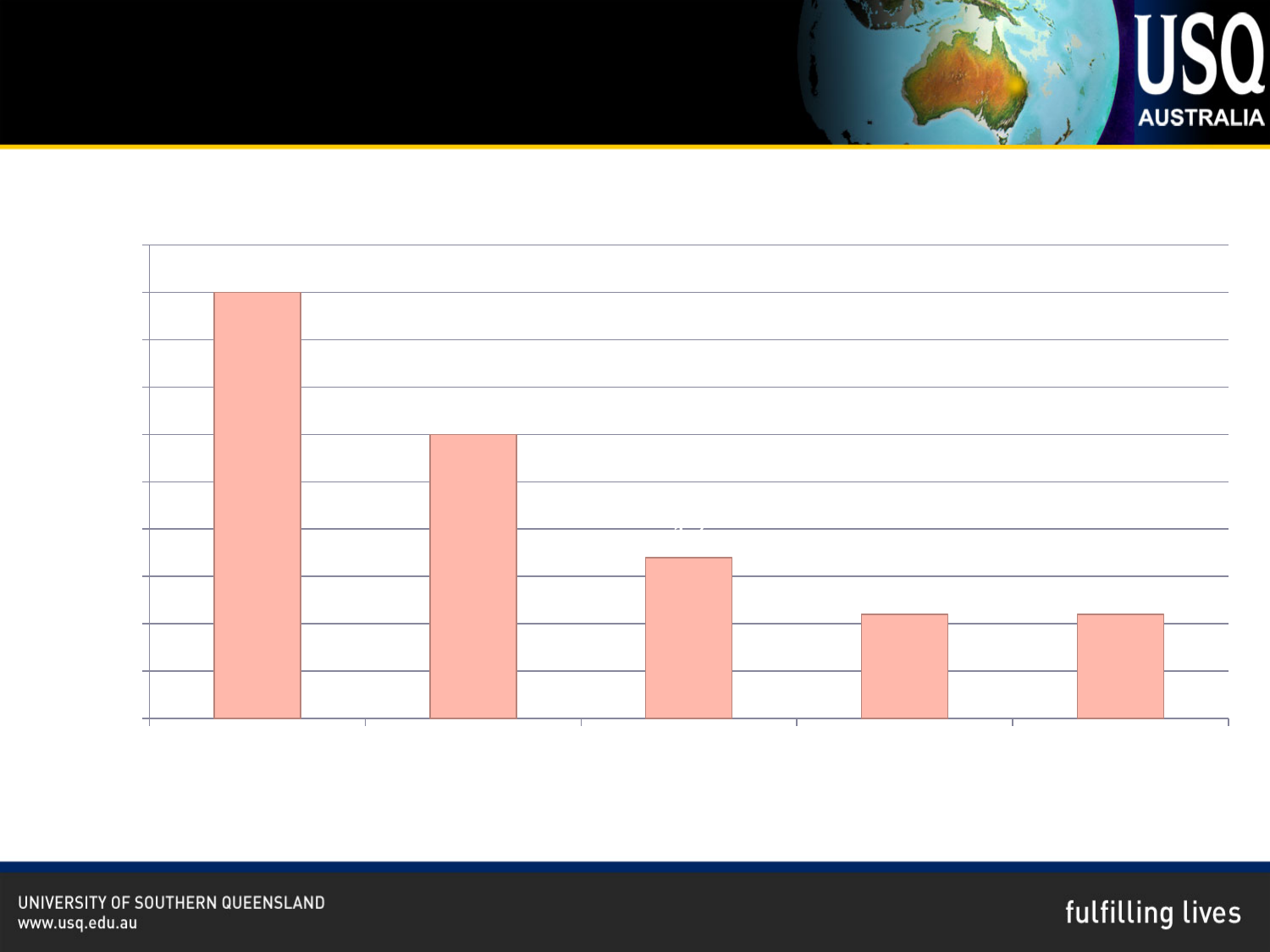
Which bar in the chart is the tallest, by position from the left? the first (leftmost) bar Does the chart display a legend? No Do the bar heights generally rise or fall from left to right across the chart? fall Is the first bar from the left taller or shorter than the second bar? taller What colour are the bars in the chart? light pink (salmon) What kind of chart is shown on the slide? bar chart Is the third bar from the left taller or shorter than the second bar? shorter How many bars are plotted in the chart? 5